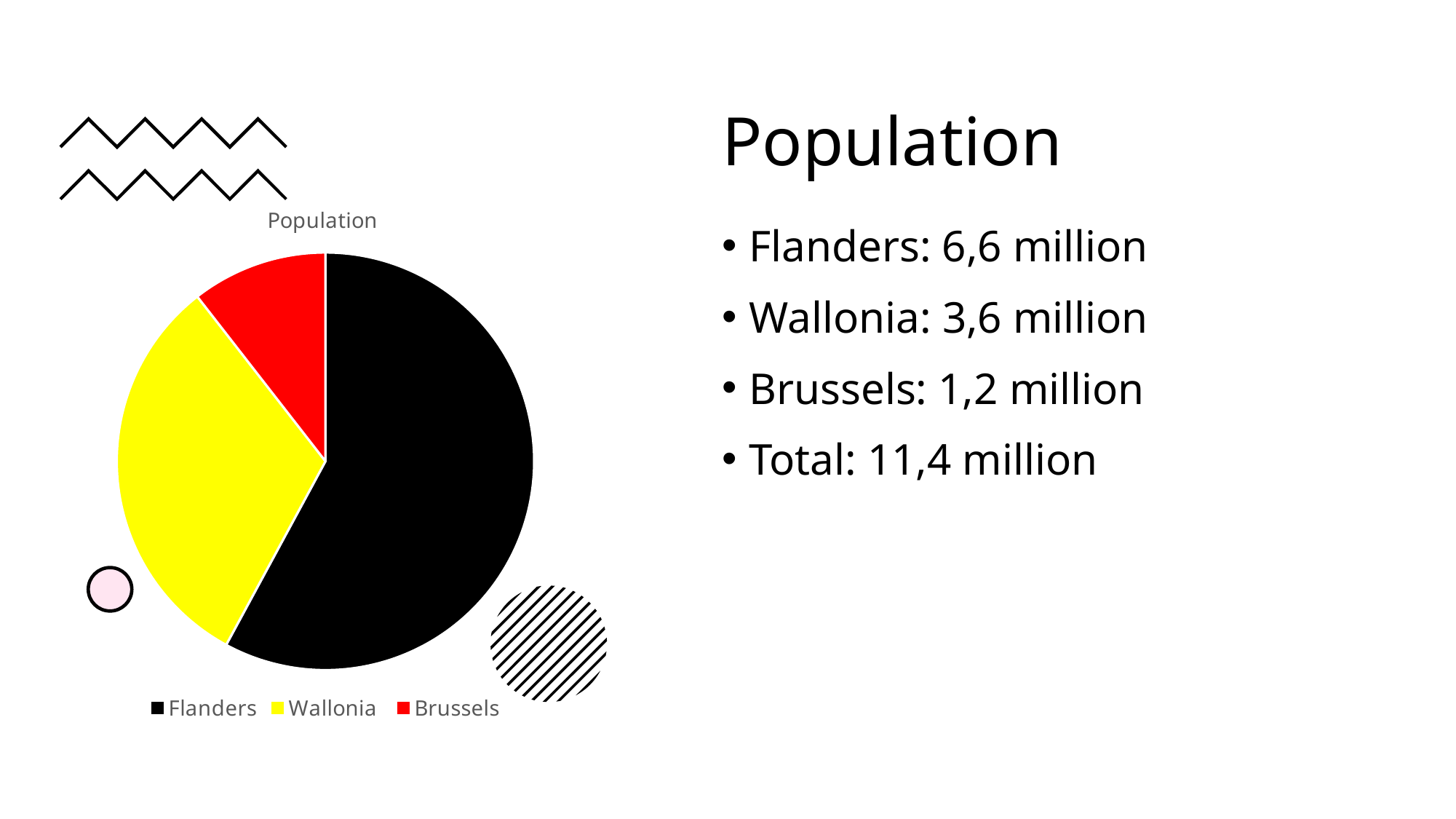
What is the population of Flanders according to the slide? 6,6 million Which region has the smallest slice in the Population pie chart? Brussels How many slices does the Population pie chart have? 3 What is the difference in population between Flanders and Wallonia? 3,0 million What kind of chart is shown on the slide? pie chart What is the total population shown on the slide? 11,4 million What colour represents Wallonia in the pie chart? yellow What is the population of Wallonia according to the slide? 3,6 million What is the population of Brussels according to the slide? 1,2 million How many entries does the legend of the pie chart list? 3 Which slice is larger in the pie chart, Wallonia or Brussels? Wallonia Which region has the largest slice in the Population pie chart? Flanders